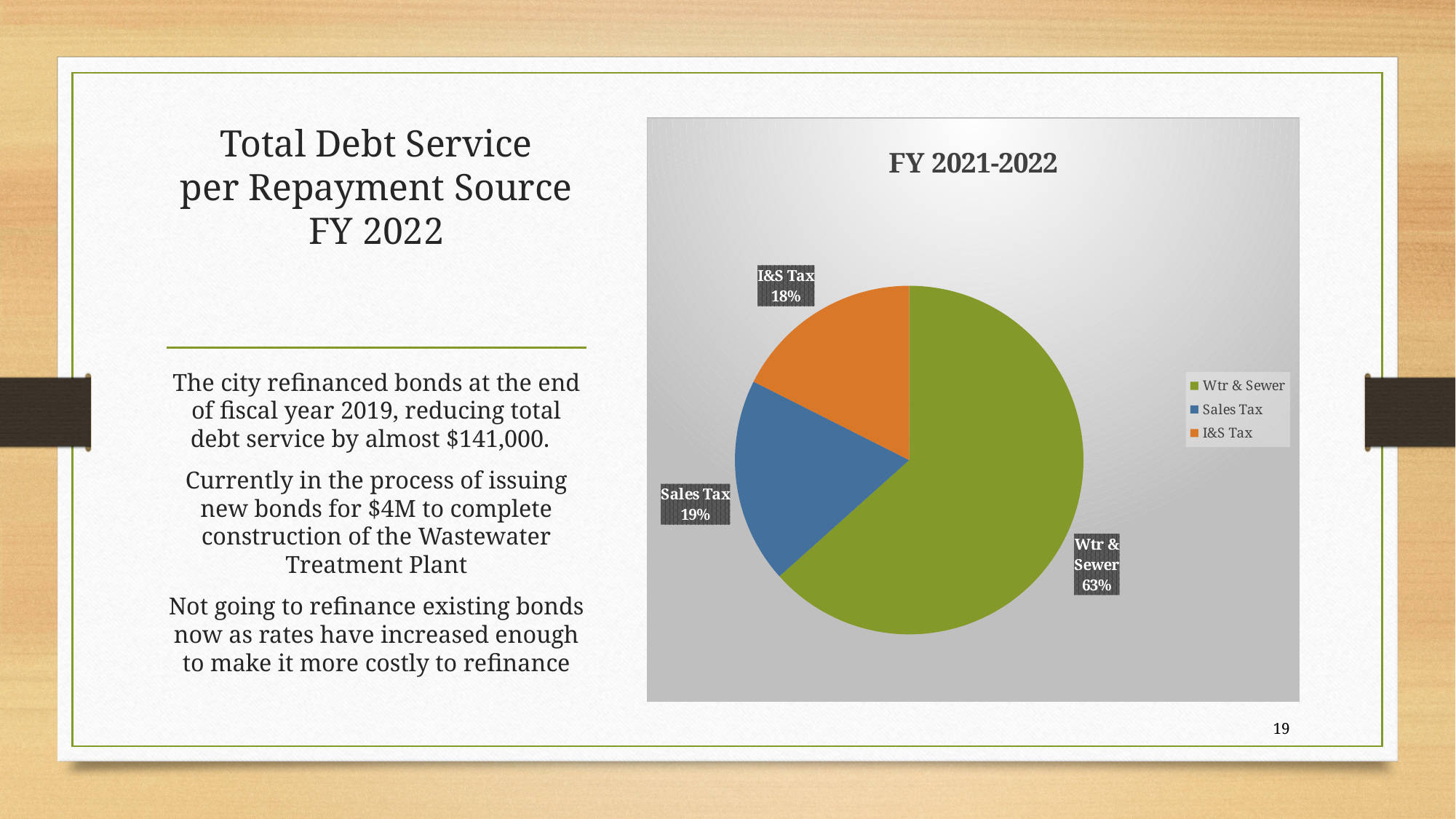
What colour is the Wtr & Sewer slice? green What is the chart's title? FY 2021-2022 How many slices does the pie chart have? 3 What share of the pie does Wtr & Sewer represent? 63% Which repayment source has the smallest share of the pie? I&S Tax What share of the pie does I&S Tax represent? 18% What kind of chart is shown on the slide? pie chart Which repayment source has the largest share of the pie? Wtr & Sewer What share of the pie does Sales Tax represent? 19% How many entries does the legend list? 3 What is the difference in percentage points between the Wtr & Sewer share and the Sales Tax share? 44 Which is larger, the Wtr & Sewer share or the I&S Tax share? Wtr & Sewer